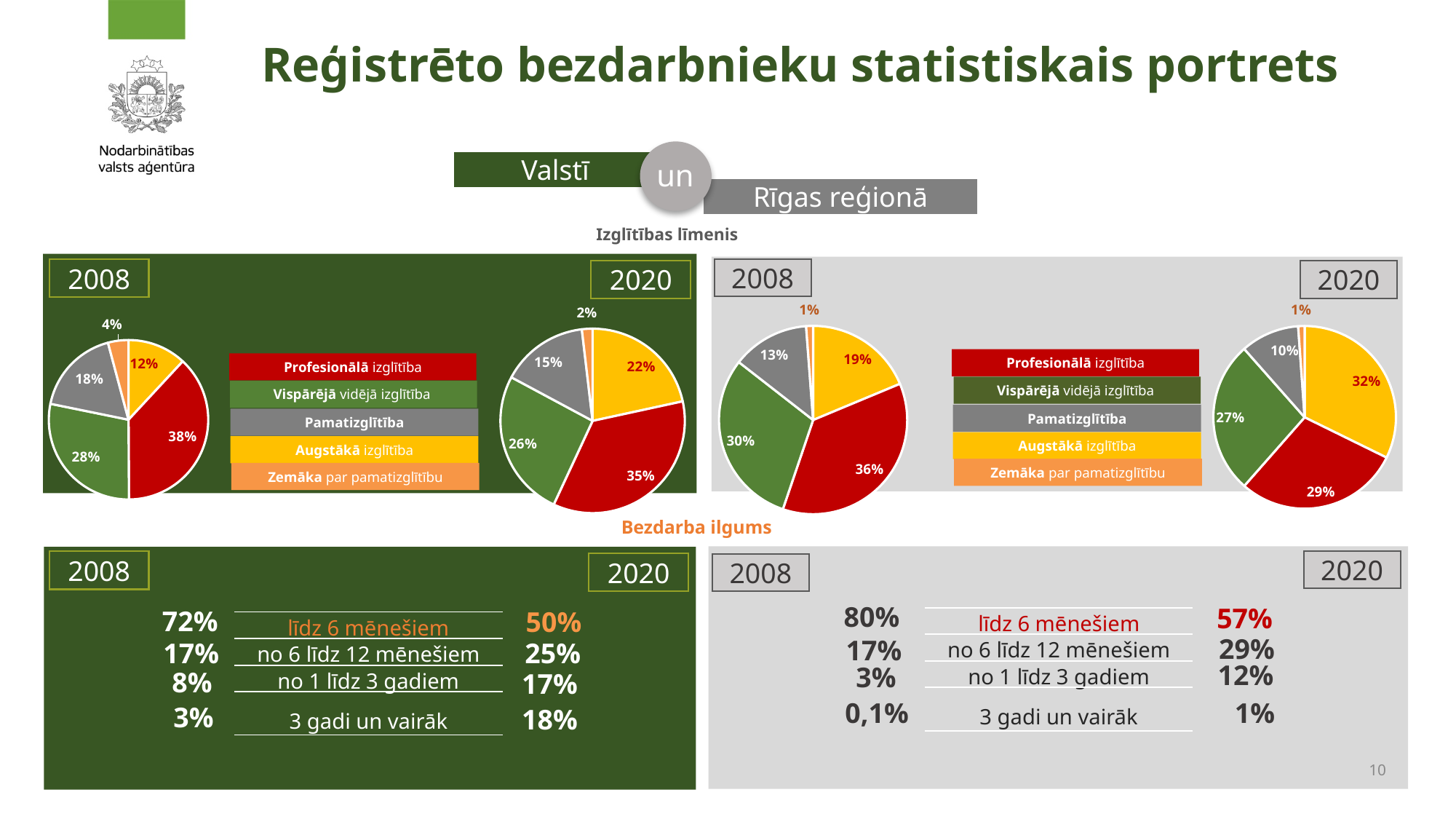
In the Rīgas reģionā 2020 pie chart, what share is Pamatizglītība? 10% In the Valstī 2020 pie chart, what share is Augstākā izglītība? 22% In the Rīgas reģionā 2008 pie chart, what share is Vispārējā vidējā izglītība? 30% How many slices does the Valstī 2020 pie chart have? 5 How many categories does the legend for the Izglītības līmenis charts list? 5 What type of chart is used to show Izglītības līmenis on the slide? Pie chart In the Valstī 2020 pie chart, what is the difference between the Profesionālā izglītība share and the Pamatizglītība share? 20% In the Valstī 2008 pie chart, what share is Profesionālā izglītība? 38% In the Valstī 2008 pie chart, which category has the smallest share? Zemāka par pamatizglītību In the Rīgas reģionā 2020 pie chart, which category has the largest share? Augstākā izglītība In the Izglītības līmenis legend, which colour represents Pamatizglītība? Grey In the Rīgas reģionā 2008 pie chart, which is larger: Augstākā izglītība or Pamatizglītība? Augstākā izglītība